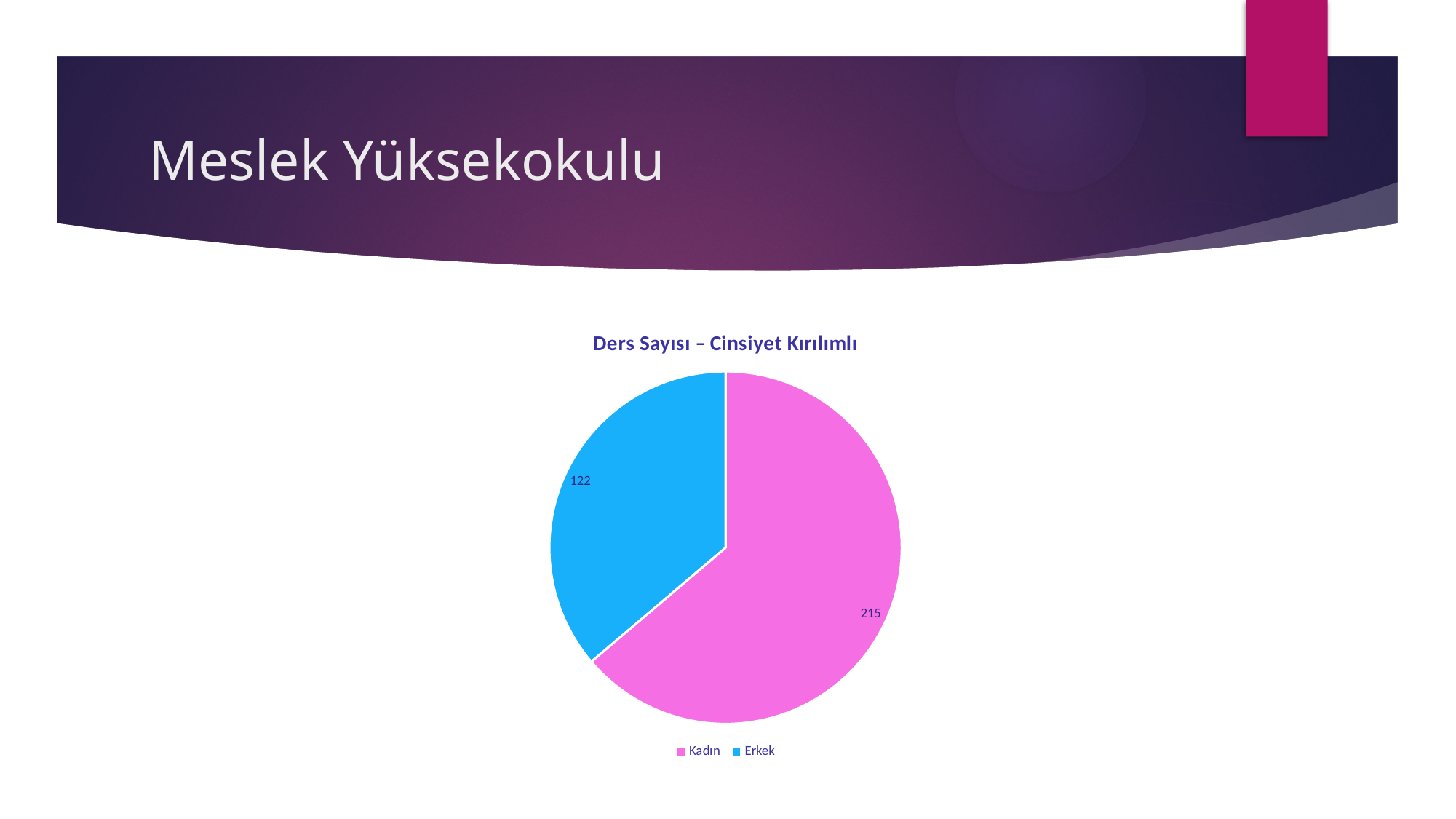
What kind of chart is shown on the slide? pie chart What is the title of the chart? Ders Sayısı – Cinsiyet Kırılımlı Which category has the largest slice? Kadın What is the value for Erkek? 122 How many entries does the legend list? 2 What is the total of all slices in the pie chart? 337 What is the value for Kadın? 215 What is the difference between the values for Kadın and Erkek? 93 What colour is the Erkek slice? blue Which category has the smallest slice? Erkek How many categories does the pie chart have? 2 Which is larger, the value for Kadın or the value for Erkek? Kadın